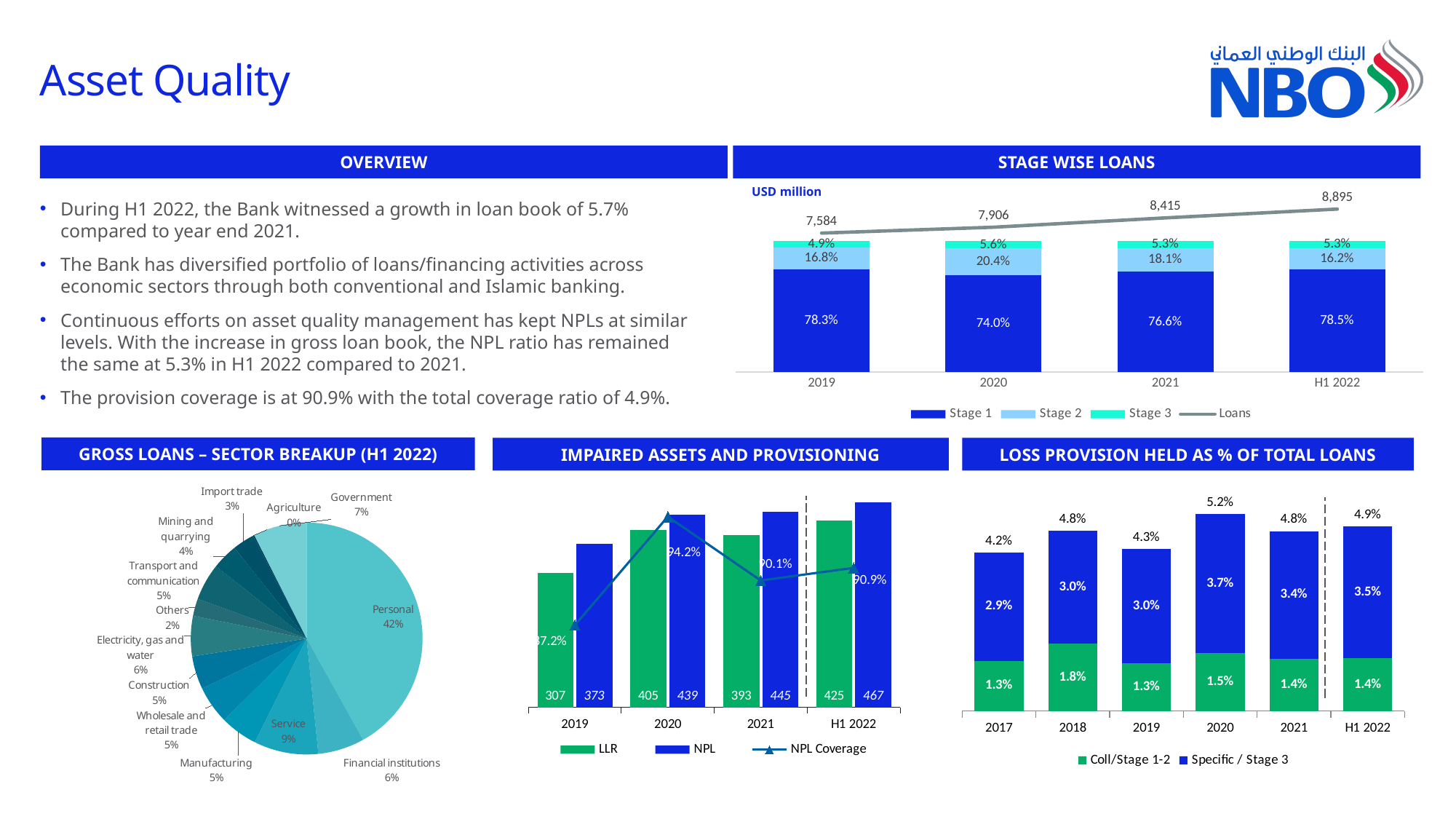
In the Stage Wise Loans chart, how many series does the legend list? 4 In the Impaired Assets and Provisioning chart, what is the NPL value for 2021? 445 In the Stage Wise Loans chart, what is the Loans value for H1 2022? 8,895 In the Impaired Assets and Provisioning chart, which year has the highest NPL Coverage? 2020 In the Impaired Assets and Provisioning chart, what is the difference between NPL and LLR in H1 2022? 42 In the Stage Wise Loans chart, what is the Stage 2 share for 2020? 20.4% In the Loss Provision Held as % of Total Loans chart, how many periods are shown on the x axis? 6 In the Gross Loans – Sector Breakup (H1 2022) chart, what share does Personal have? 42% In the Stage Wise Loans chart, which year has the lowest Stage 1 share? 2020 In the Loss Provision Held as % of Total Loans chart, what is the Specific / Stage 3 value for 2020? 3.7% In the Gross Loans – Sector Breakup (H1 2022) chart, what kind of chart is shown? Pie chart In the Loss Provision Held as % of Total Loans chart, what is the total for 2017? 4.2%